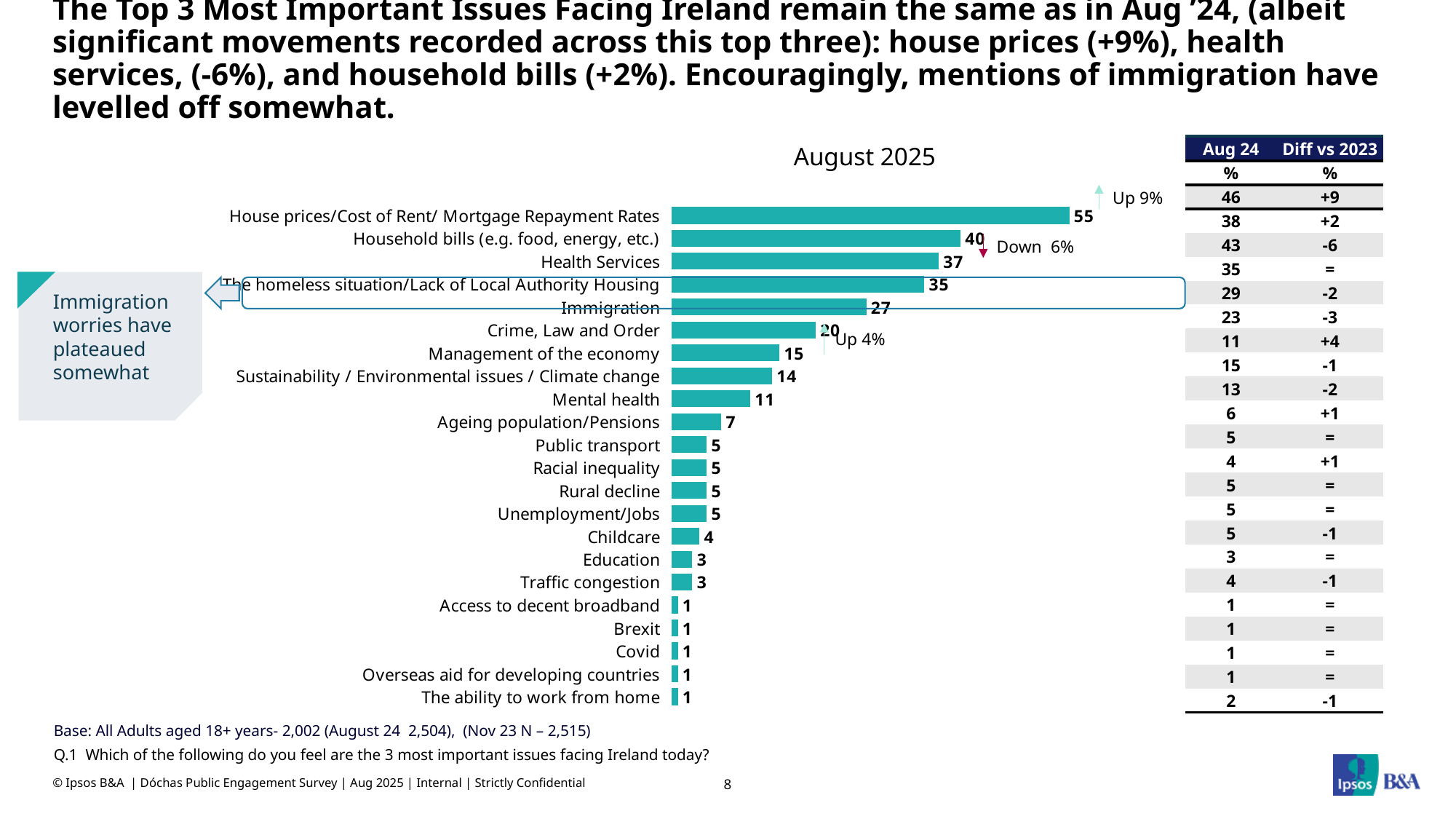
What is the value for Health Services in the August 2025 chart? 37 What is the difference between the values for House prices/Cost of Rent/ Mortgage Repayment Rates and Household bills in the August 2025 chart? 15 Which is larger in the August 2025 chart: Crime, Law and Order or Management of the economy? Crime, Law and Order What is the title of the bar chart on the slide? August 2025 Which category has the highest value in the August 2025 chart? House prices/Cost of Rent/ Mortgage Repayment Rates What is the value for Mental health in the August 2025 chart? 11 What is the value for Childcare in the August 2025 chart? 4 What kind of chart is used to show the August 2025 data? Bar chart What is the difference between the values for The homeless situation/Lack of Local Authority Housing and Immigration in the August 2025 chart? 8 How many categories are shown in the August 2025 chart? 22 What is the value for Immigration in the August 2025 chart? 27 What is the value for Ageing population/Pensions in the August 2025 chart? 7